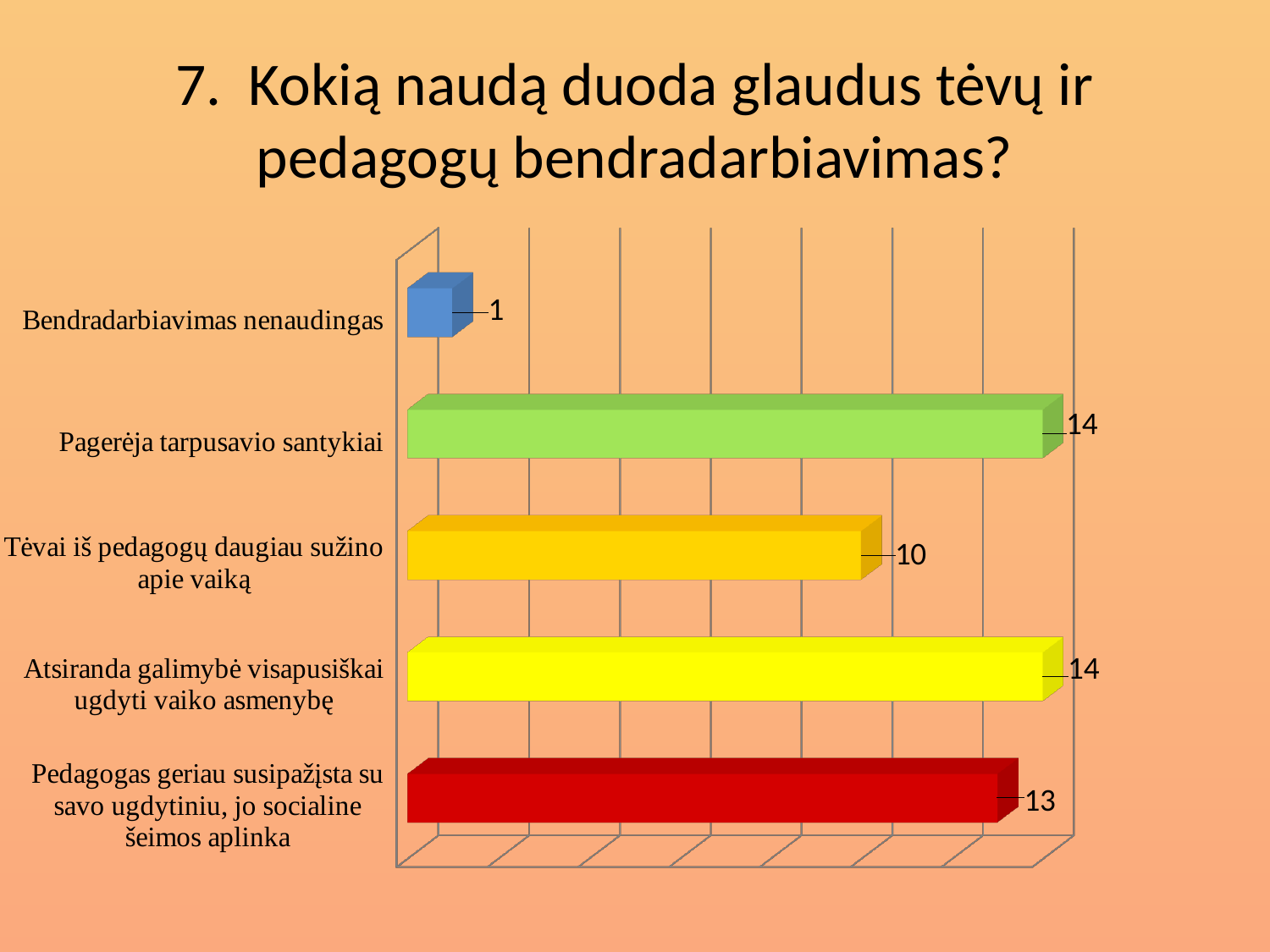
What is the difference between the values for "Pedagogas geriau susipažįsta su savo ugdytiniu, jo socialine šeimos aplinka" and "Bendradarbiavimas nenaudingas"? 12 What value is shown for "Bendradarbiavimas nenaudingas"? 1 Which category has the lowest value? Bendradarbiavimas nenaudingas How many categories are shown in the chart? 5 What kind of chart is shown on the slide? Bar chart What is the difference between the values for "Pagerėja tarpusavio santykiai" and "Tėvai iš pedagogų daugiau sužino apie vaiką"? 4 What value is shown for "Atsiranda galimybė visapusiškai ugdyti vaiko asmenybę"? 14 What value is shown for "Pagerėja tarpusavio santykiai"? 14 What colour is the bar for "Pedagogas geriau susipažįsta su savo ugdytiniu, jo socialine šeimos aplinka"? Red What value is shown for "Pedagogas geriau susipažįsta su savo ugdytiniu, jo socialine šeimos aplinka"? 13 What value is shown for "Tėvai iš pedagogų daugiau sužino apie vaiką"? 10 Which is larger: the value for "Pedagogas geriau susipažįsta su savo ugdytiniu, jo socialine šeimos aplinka" or the value for "Tėvai iš pedagogų daugiau sužino apie vaiką"? Pedagogas geriau susipažįsta su savo ugdytiniu, jo socialine šeimos aplinka